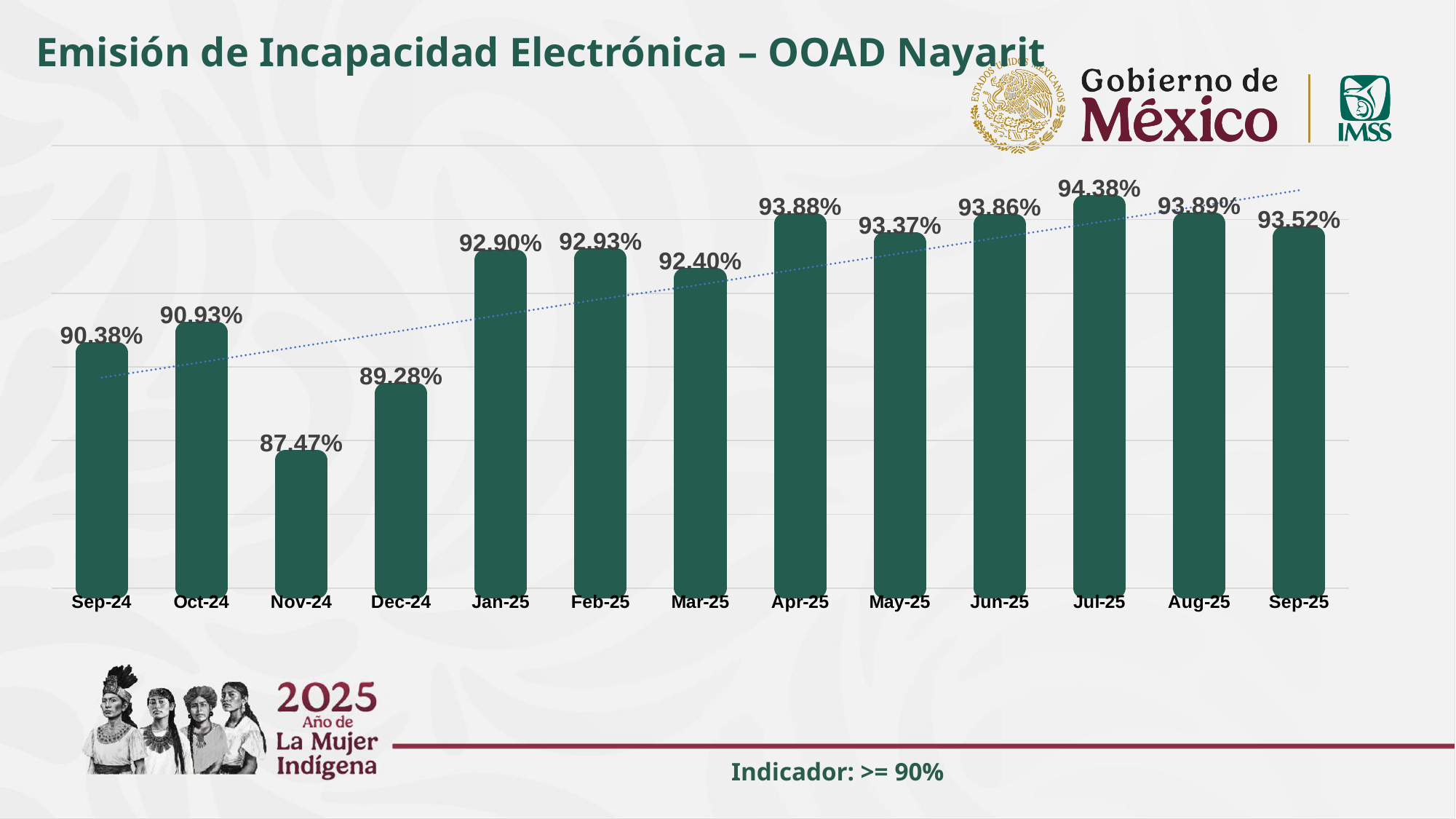
Which is larger, the value for Apr-25 or the value for Mar-25? Apr-25 Which month has the highest value? Jul-25 What is the difference between the values for Jan-25 and Dec-24? 3.62 percentage points What is the value for Dec-24? 89.28% Which month has the lowest value? Nov-24 What is the value for Jul-25? 94.38% What is the difference between the values for Jul-25 and Nov-24? 6.91 percentage points What is the value for Nov-24? 87.47% What kind of chart is shown on the slide? Bar chart How many months are shown on the x axis? 13 What is the title of the chart? Emisión de Incapacidad Electrónica – OOAD Nayarit What is the value for Sep-25? 93.52%